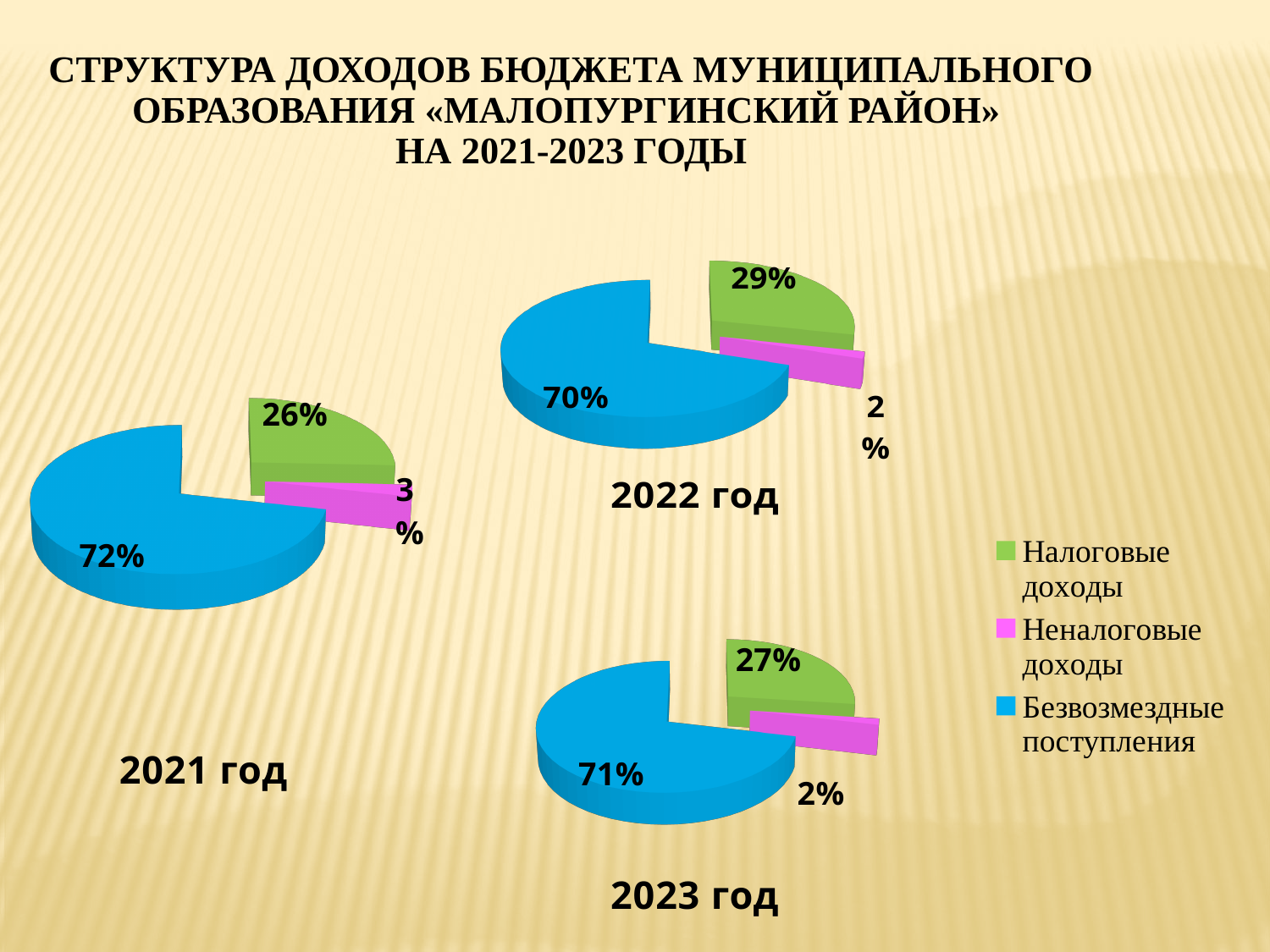
In the 2023 год pie chart, which category has the largest share? Безвозмездные поступления In the 2022 год pie chart, what share is shown for Безвозмездные поступления? 70% In the 2022 год pie chart, what share is shown for Налоговые доходы? 29% What type of chart is used for the 2023 год data? Pie chart In the 2021 год pie chart, what share is shown for Неналоговые доходы? 3% Which is larger: the share of Налоговые доходы in the 2022 год chart or in the 2023 год chart? 2022 год How many pie charts are shown on the slide? 3 In the 2021 год pie chart, what is the difference between the shares of Безвозмездные поступления and Налоговые доходы? 46% In the 2022 год pie chart, which category has the smallest share? Неналоговые доходы